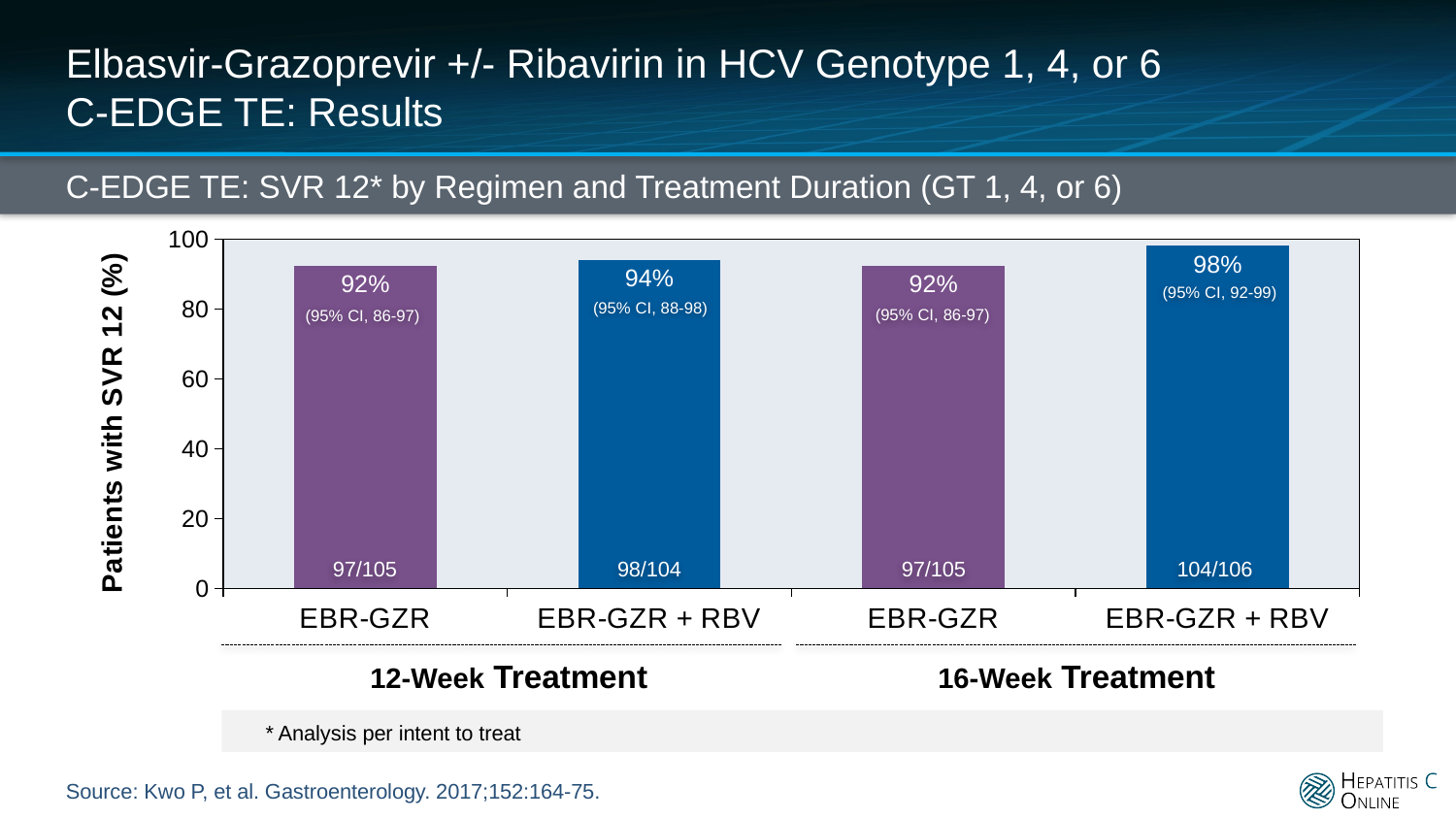
What type of chart is shown on the slide? Bar chart What is the 95% CI shown for EBR-GZR + RBV in the 12-Week Treatment group? 88-98 What is the difference in SVR 12 rate between EBR-GZR + RBV in the 16-Week group and EBR-GZR in the 16-Week group? 6% What is the SVR 12 rate for EBR-GZR + RBV in the 12-Week Treatment group? 94% What fraction of patients is shown for EBR-GZR + RBV in the 16-Week Treatment group? 104/106 How many bars are shown in the chart? 4 What is the SVR 12 rate for EBR-GZR in the 12-Week Treatment group? 92% Is the SVR 12 rate for EBR-GZR in the 16-Week Treatment group greater or less than 80? greater What is the title of the chart? C-EDGE TE: SVR 12* by Regimen and Treatment Duration (GT 1, 4, or 6) What is the SVR 12 rate for EBR-GZR + RBV in the 16-Week Treatment group? 98% Which bar has the highest SVR 12 rate? EBR-GZR + RBV, 16-Week Treatment Which has a higher SVR 12 rate: EBR-GZR + RBV at 12 weeks or EBR-GZR + RBV at 16 weeks? EBR-GZR + RBV at 16 weeks